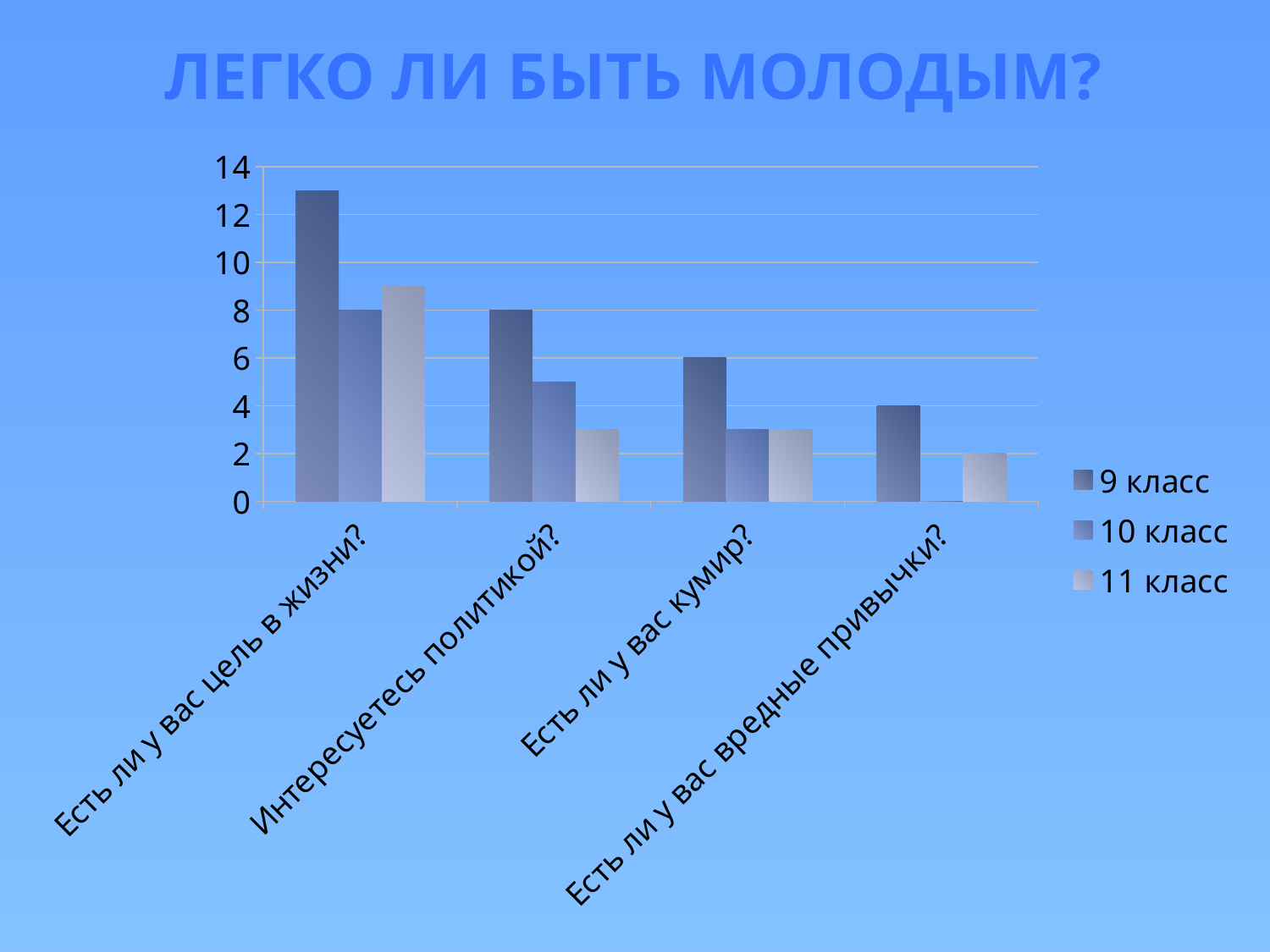
How many question categories are shown on the x axis? 4 Do the 9 класс values rise or fall from left to right across the categories? fall For "Есть ли у вас цель в жизни?", which is larger: the value for 10 класс or 11 класс? 11 класс What is the value for 9 класс for "Интересуетесь политикой?"? 8 What is the value for 9 класс for "Есть ли у вас вредные привычки?"? 4 What is the value for 10 класс for "Есть ли у вас цель в жизни?"? 8 For which question category is the 9 класс bar the highest? Есть ли у вас цель в жизни? What kind of chart is shown on the slide? bar chart Is the value for 11 класс for "Интересуетесь политикой?" greater or less than 4? less Is the value for 9 класс for "Есть ли у вас цель в жизни?" greater or less than 12? greater How many series does the legend list? 3 What is the value for 9 класс for "Есть ли у вас кумир?"? 6